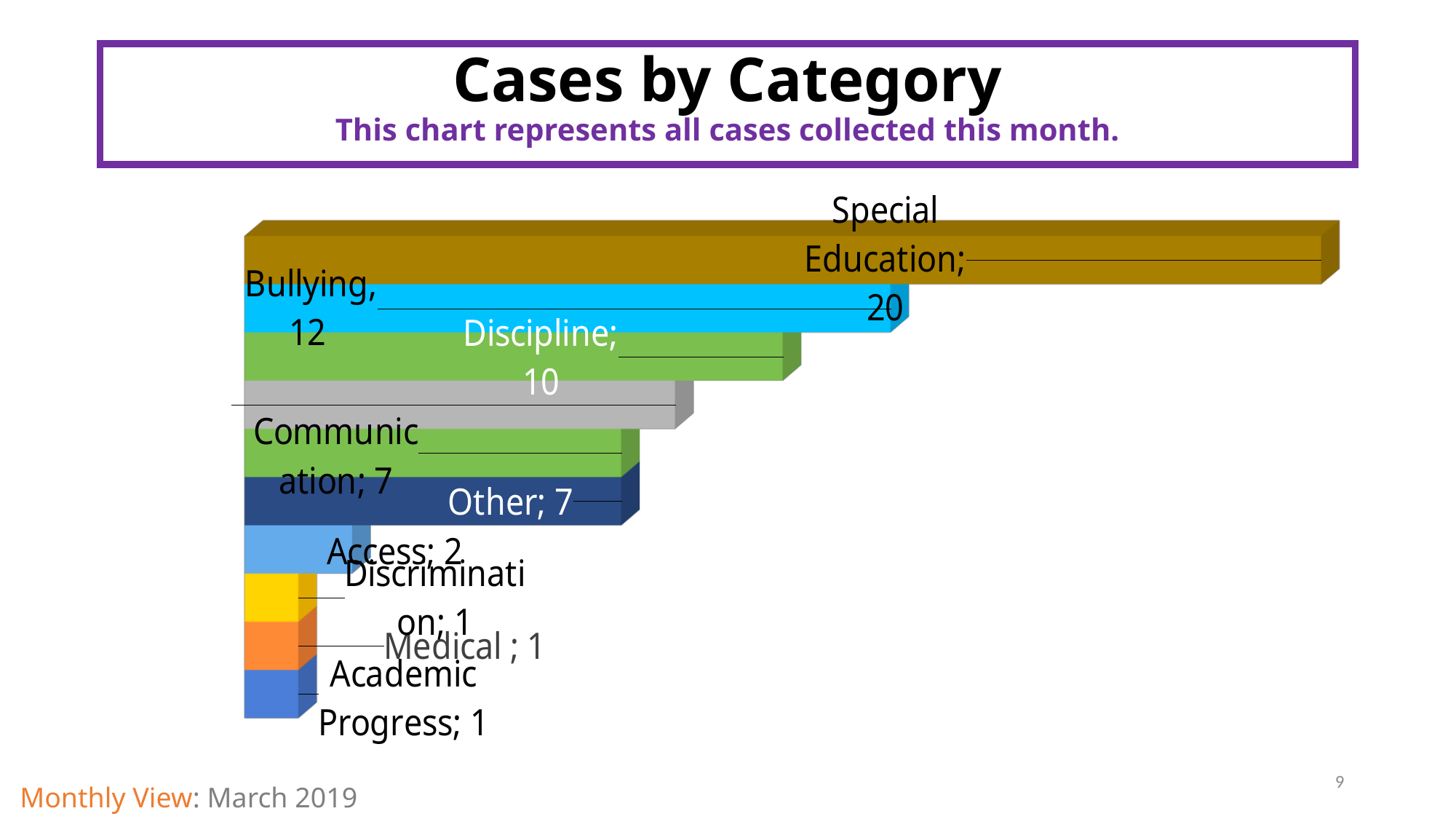
What is the difference between the values for Discipline and Other? 3 What is the value for Special Education? 20 What is the value for Bullying? 12 How many bars are plotted in the chart? 10 What is the value for Access? 2 What is the value for Academic Progress? 1 What is the title of the chart on the slide? Cases by Category What is the value for Discipline? 10 Which category has the highest number of cases? Special Education What kind of chart is shown on the slide? Bar chart What is the difference between the values for Special Education and Bullying? 8 Which is larger, the value for Bullying or the value for Discipline? Bullying